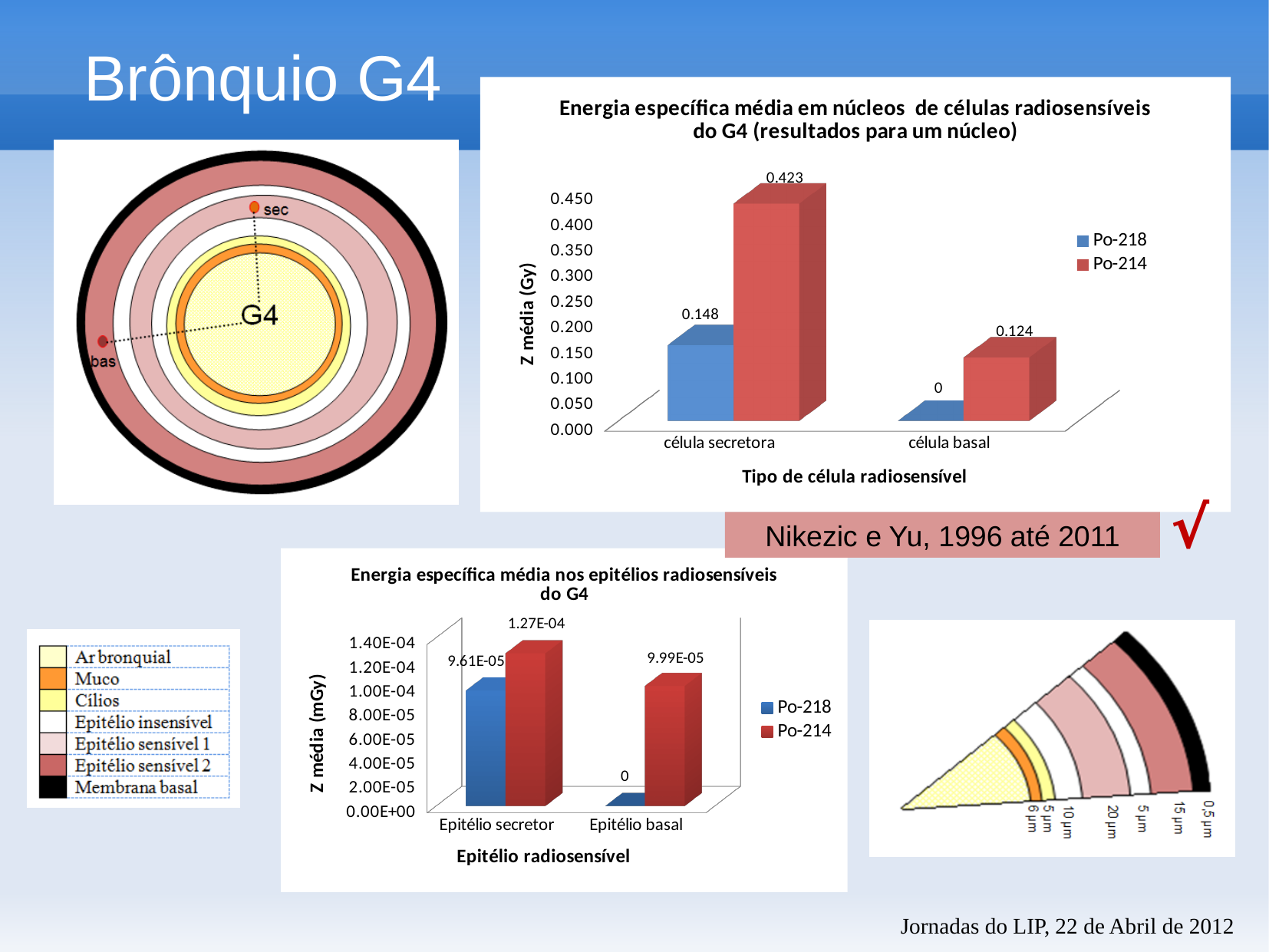
In the top chart (Energia específica média em núcleos de células radiosensíveis do G4), how many series does the legend list? 2 In the top chart (Energia específica média em núcleos de células radiosensíveis do G4), what is the label of the y axis? Z média (Gy) In the top chart (Energia específica média em núcleos de células radiosensíveis do G4), what is the Po-218 value for célula secretora? 0.148 In the bottom chart (Energia específica média nos epitélios radiosensíveis do G4), what is the Po-218 value for Epitélio basal? 0 In the top chart (Energia específica média em núcleos de células radiosensíveis do G4), what is the difference between the Po-214 and Po-218 values for célula secretora? 0.275 In the bottom chart (Energia específica média nos epitélios radiosensíveis do G4), what is the Po-214 value for Epitélio secretor? 1.27E-04 In the top chart (Energia específica média em núcleos de células radiosensíveis do G4), what is the Po-214 value for célula secretora? 0.423 In the top chart (Energia específica média em núcleos de células radiosensíveis do G4), what is the Po-214 value for célula basal? 0.124 In the bottom chart (Energia específica média nos epitélios radiosensíveis do G4), which category has the highest Po-214 value? Epitélio secretor In the bottom chart (Energia específica média nos epitélios radiosensíveis do G4), what is the Po-214 value for Epitélio basal? 9.99E-05 What kind of chart is the bottom chart (Energia específica média nos epitélios radiosensíveis do G4)? Bar chart In the top chart (Energia específica média em núcleos de células radiosensíveis do G4), which series has the higher value for célula basal, Po-218 or Po-214? Po-214